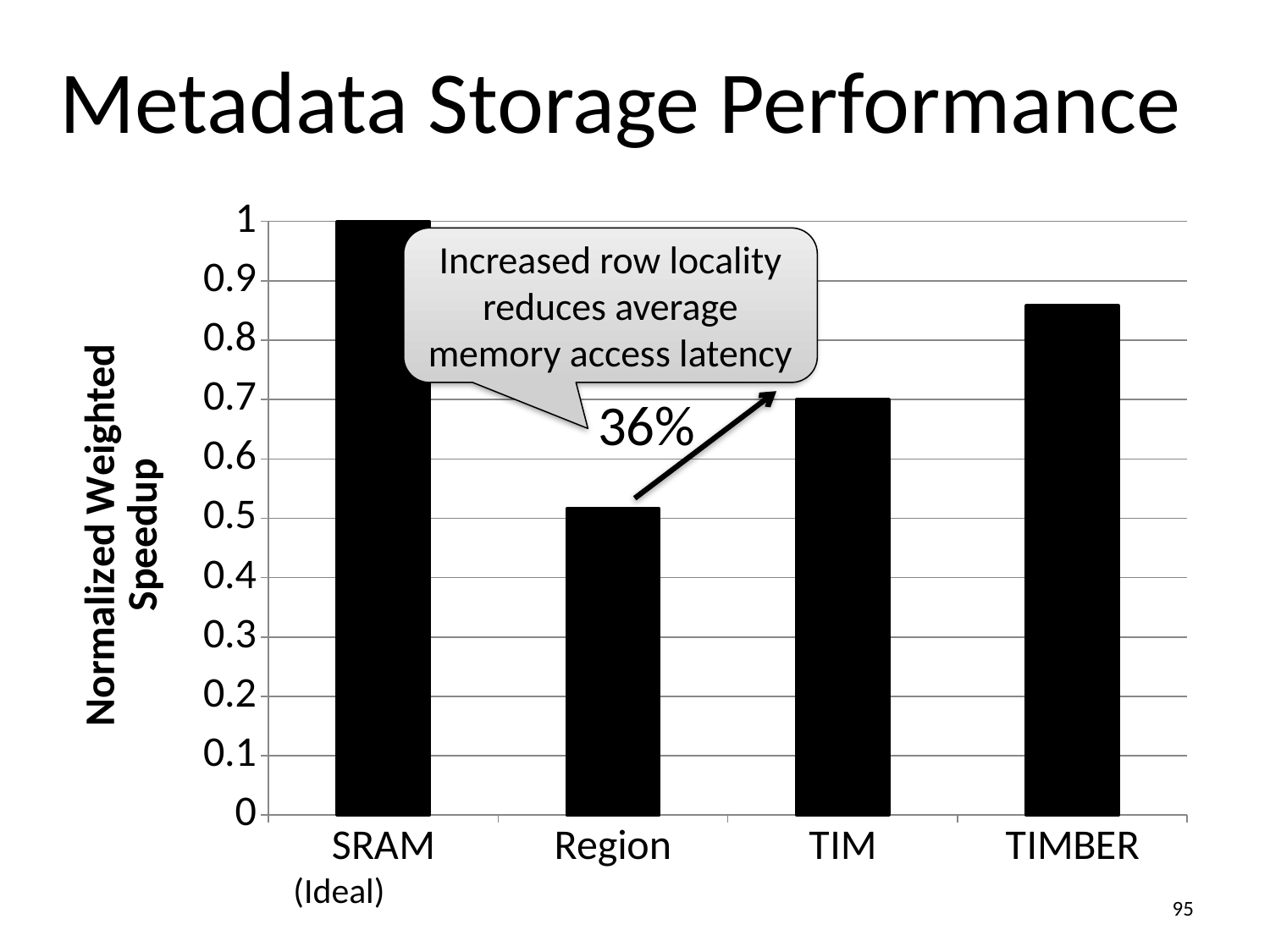
Which has a higher normalized weighted speedup, Region or TIM? TIM Is the value for TIMBER greater or less than 0.8? greater What kind of chart is shown on the slide? bar chart What is the label of the y axis? Normalized Weighted Speedup How many categories are plotted on the x axis? 4 Which category has the highest normalized weighted speedup? SRAM (Ideal) Which has a higher normalized weighted speedup, TIMBER or TIM? TIMBER Which category has the lowest normalized weighted speedup? Region What percentage is annotated next to the arrow between the Region and TIM bars? 36% Is the value for TIM greater or less than 0.6? greater What is the normalized weighted speedup for SRAM (Ideal)? 1 Is the value for Region greater or less than 0.6? less